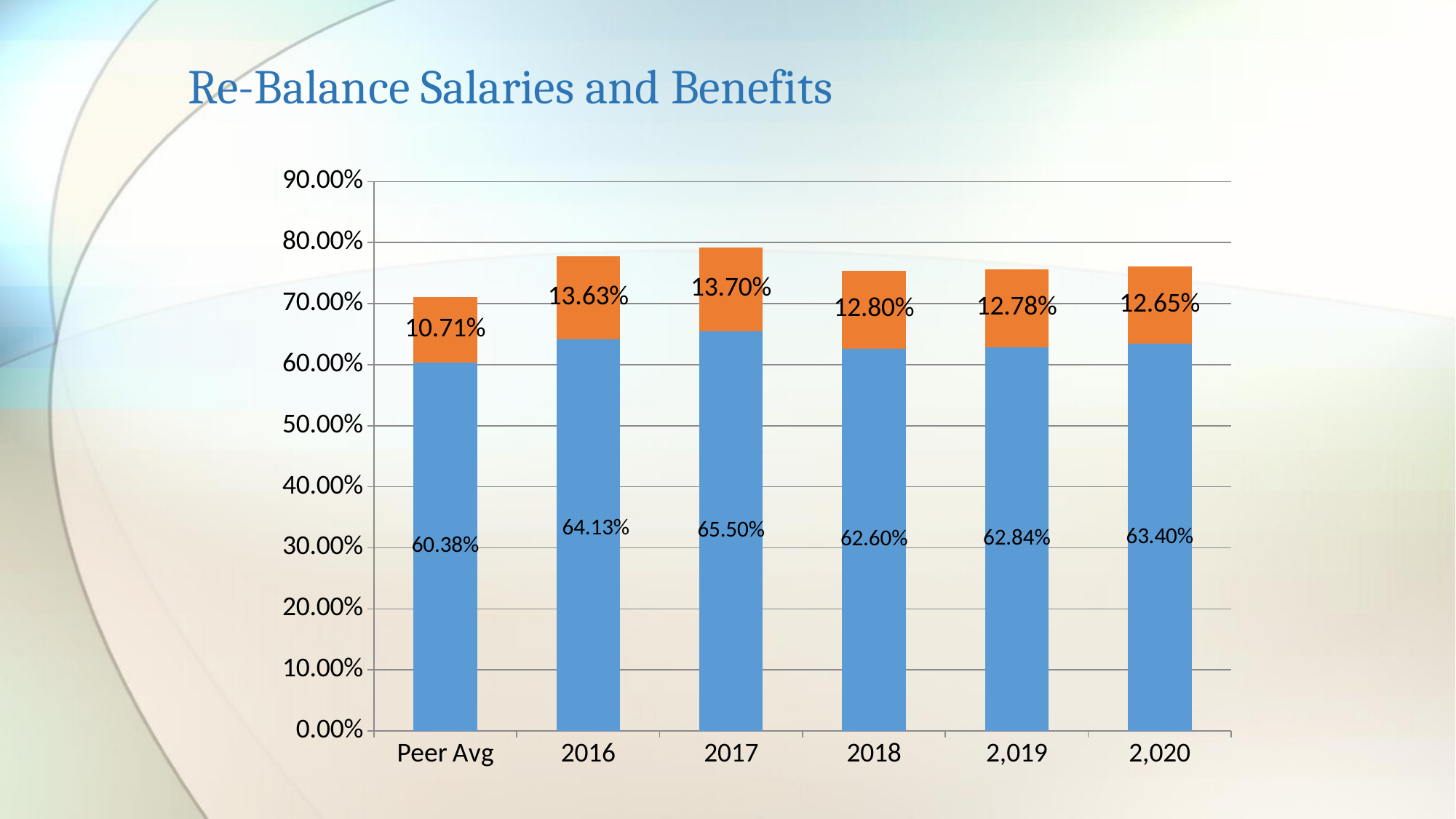
What is the value of the blue segment for 2017? 65.50% What is the value of the orange segment for Peer Avg? 10.71% Which category has the lowest orange segment value? Peer Avg What is the value of the orange segment for 2018? 12.80% How many categories are shown on the x axis? 6 What kind of chart is shown on the slide? stacked bar chart What is the difference between the blue segment values for 2017 and Peer Avg? 5.12% What is the total of the stacked bar for 2017? 79.20% Which is larger, the orange segment for 2016 or the orange segment for 2,020? 2016 Which category has the highest blue segment value? 2017 Is the total height of the Peer Avg bar greater or less than 80.00%? less What is the title of the slide? Re-Balance Salaries and Benefits